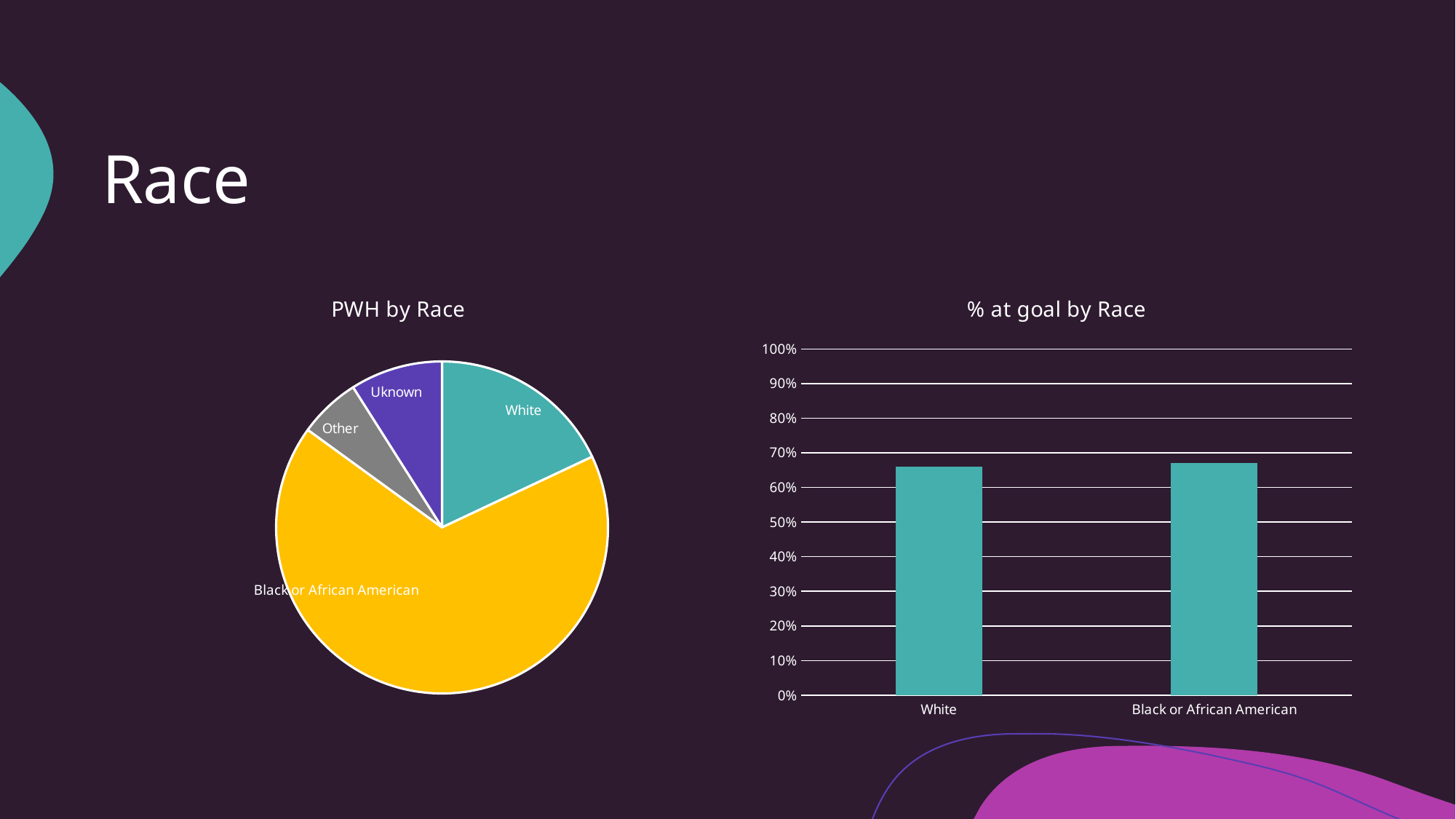
In the "PWH by Race" pie chart, which slice is larger, White or Other? White In the "% at goal by Race" bar chart, is the value for Black or African American greater or less than 70%? less What kind of chart is the "% at goal by Race" chart on the right? bar chart In the "PWH by Race" pie chart, which race has the largest slice? Black or African American In the "PWH by Race" pie chart, which slice is larger, White or Black or African American? Black or African American What kind of chart is the "PWH by Race" chart on the left? pie chart In the "% at goal by Race" bar chart, is the value for White greater or less than 60%? greater In the "PWH by Race" pie chart, how many slices are there? 4 What is the title of the pie chart on the left of the slide? PWH by Race In the "PWH by Race" pie chart, which race has the smallest slice? Other In the "% at goal by Race" bar chart, how many categories are shown on the x axis? 2 What is the title of the bar chart on the right of the slide? % at goal by Race